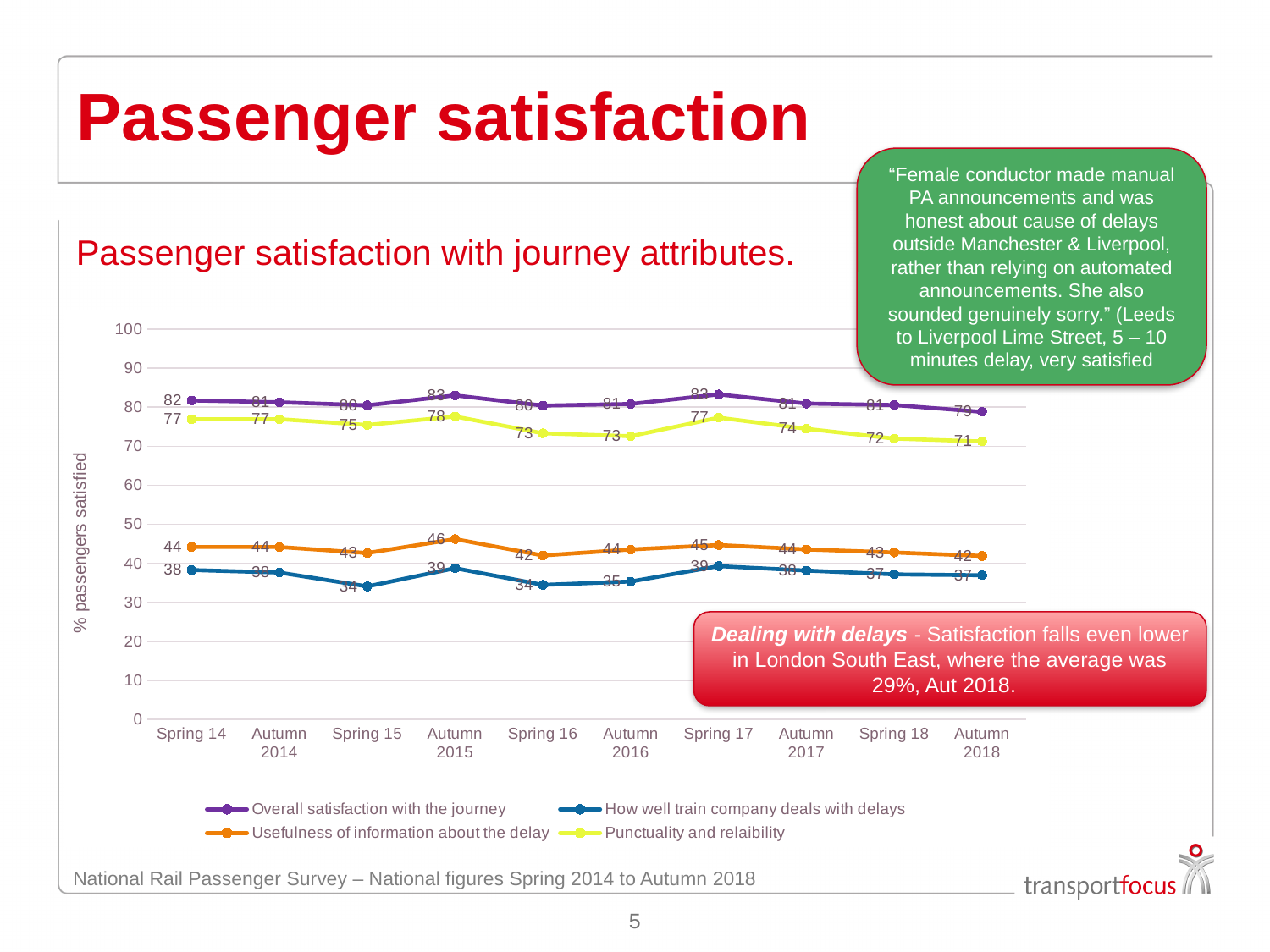
Is the value for Usefulness of information about the delay in Spring 16 greater or less than 50? less What is the value for Punctuality and reliability in Autumn 2018? 71 What is the difference between Punctuality and reliability in Spring 14 and Autumn 2018? 6 What is the value for How well train company deals with delays in Spring 17? 39 What is the label of the y axis? % passengers satisfied What is the value for Usefulness of information about the delay in Autumn 2015? 46 Which series has the lowest values across the chart? How well train company deals with delays What is the value for Overall satisfaction with the journey in Spring 14? 82 What type of chart is shown on the slide? Line chart In which period is Punctuality and reliability highest? Autumn 2015 How many series does the legend list? 4 How many survey periods are shown on the x axis? 10